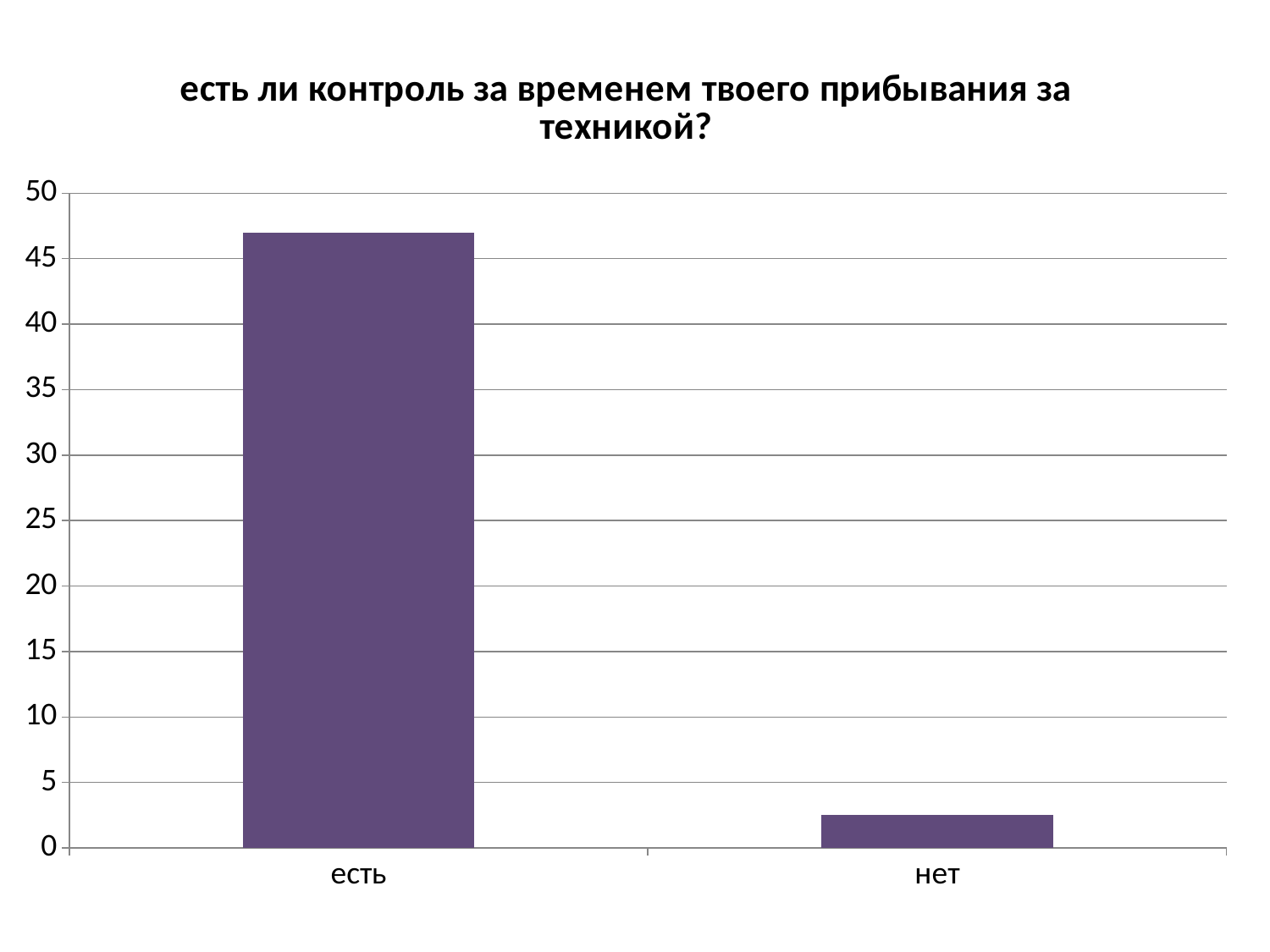
Is the value for есть greater or less than 45? greater Which is larger, the value for есть or the value for нет? есть Do the values rise or fall from есть to нет along the x axis? fall Which category has the highest value? есть What is the highest value shown on the vertical axis? 50 What kind of chart is shown on the slide? bar chart Is the value for есть greater or less than 50? less Which category has the lowest value? нет Is the value for нет greater or less than 10? less What is the title of the chart? есть ли контроль за временем твоего прибывания за техникой? How many categories are shown on the x axis? 2